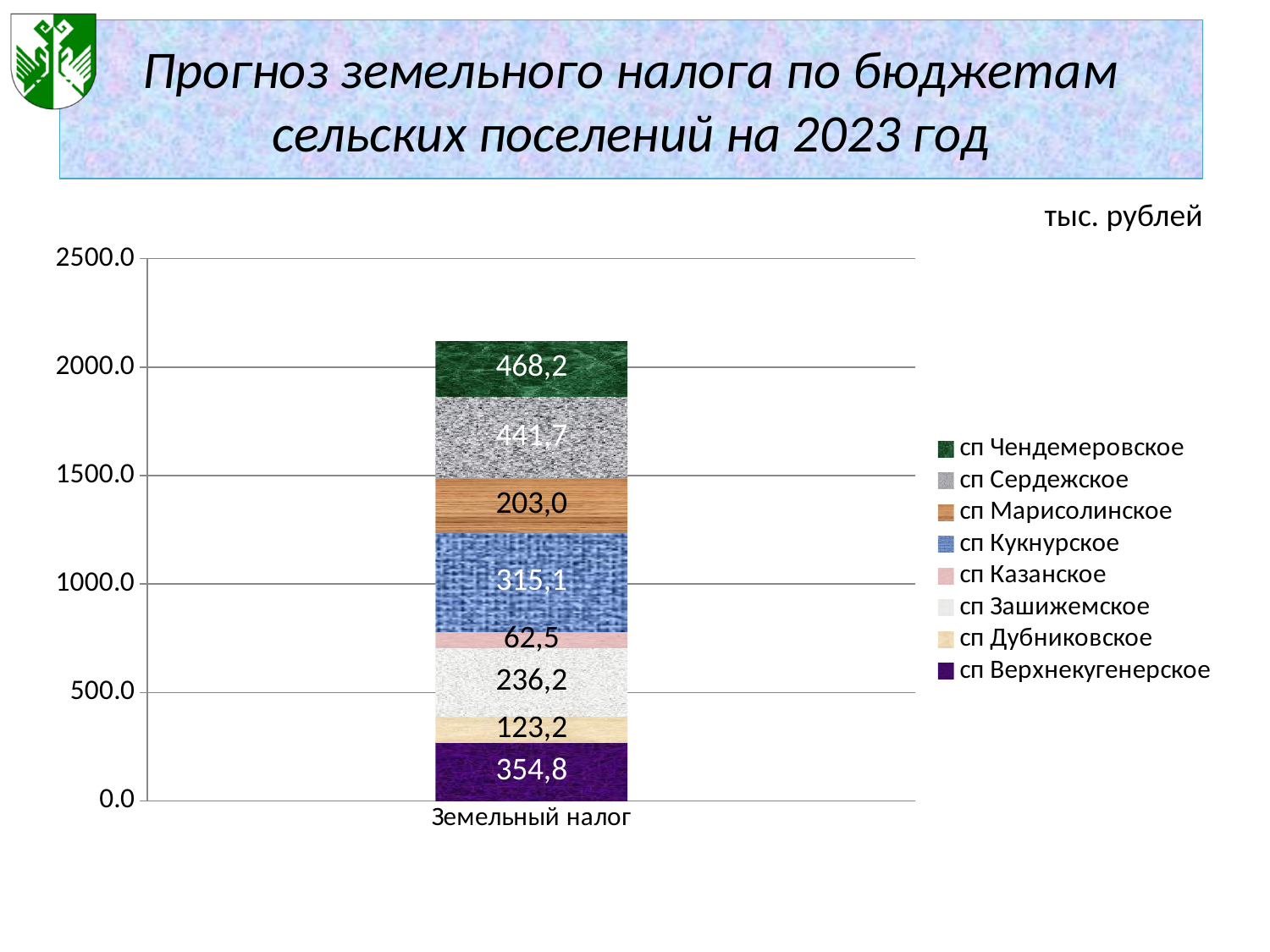
What is the value for сп Казанское? 62,5 What is the value for сп Верхнекугенерское? 354,8 What is the value for сп Кукнурское? 315,1 What is the total of the stacked bar for Земельный налог? 2204,7 What type of chart is shown on the slide? stacked bar chart Which settlement has the lowest value in the stacked bar? сп Казанское Which settlement has the highest value in the stacked bar? сп Чендемеровское What is the value for сп Чендемеровское? 468,2 What is the difference between the values for сп Сердежское and сп Марисолинское? 238,7 What unit is stated above the chart? тыс. рублей How many series does the legend list? 8 Which is larger, the value for сп Зашижемское or сп Дубниковское? сп Зашижемское